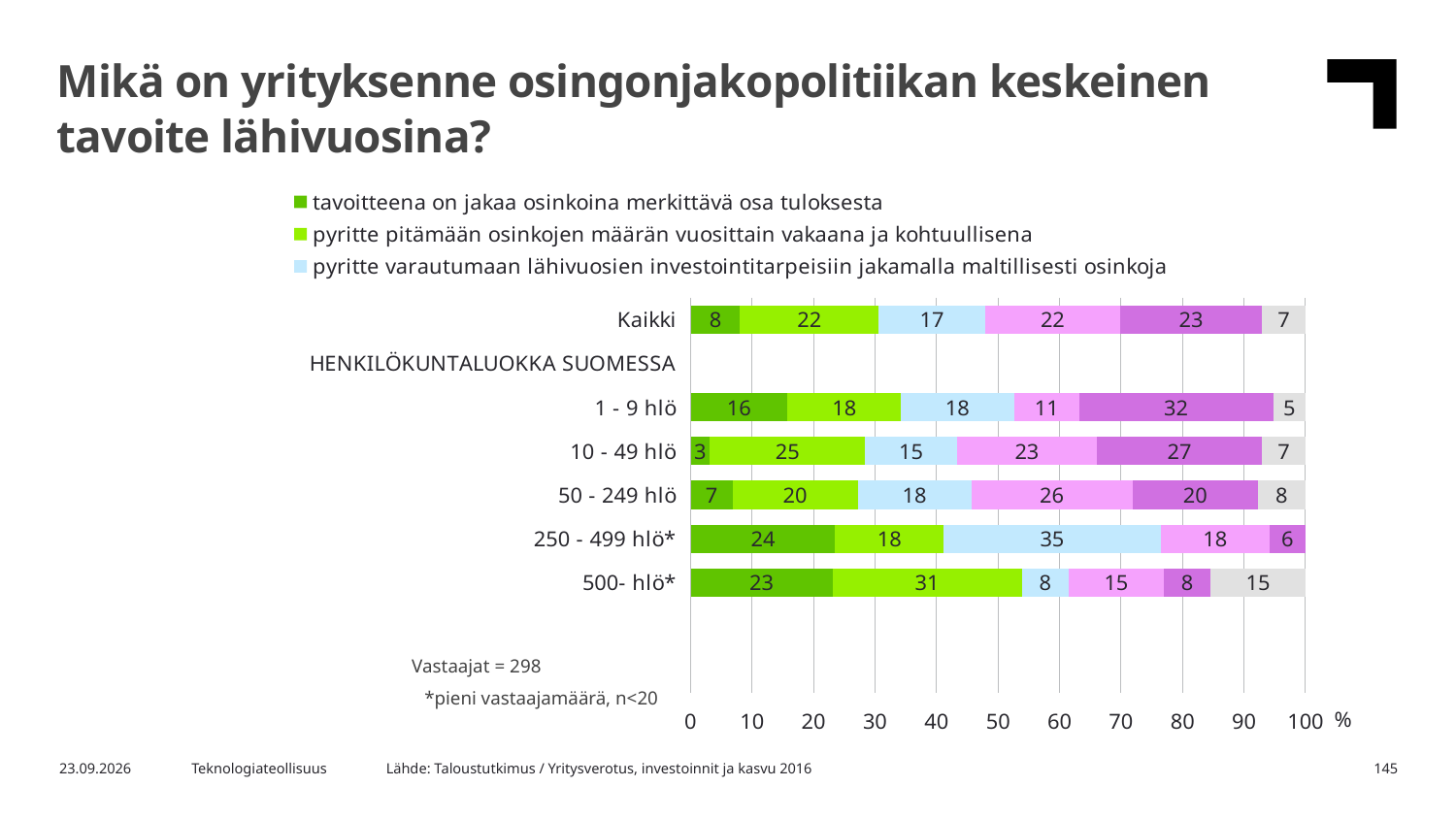
How many series does the legend list? 3 What is the value for 'pyritte pitämään osinkojen määrän vuosittain vakaana ja kohtuullisena' for 10 - 49 hlö? 25 What kind of chart is shown on the slide? bar chart Which category has the lowest value for 'pyritte varautumaan lähivuosien investointitarpeisiin jakamalla maltillisesti osinkoja'? 500- hlö* What is the title of the chart on the slide? Mikä on yrityksenne osingonjakopolitiikan keskeinen tavoite lähivuosina? How many categories have bars plotted in the chart? 6 Which category has the lowest value for 'tavoitteena on jakaa osinkoina merkittävä osa tuloksesta'? 10 - 49 hlö In the Kaikki bar, what is the difference between the value for 'pyritte pitämään osinkojen määrän vuosittain vakaana ja kohtuullisena' and the value for 'tavoitteena on jakaa osinkoina merkittävä osa tuloksesta'? 14 Which category has the highest value for 'pyritte pitämään osinkojen määrän vuosittain vakaana ja kohtuullisena'? 500- hlö* What is the value for 'tavoitteena on jakaa osinkoina merkittävä osa tuloksesta' in the Kaikki bar? 8 What is the value for 'pyritte varautumaan lähivuosien investointitarpeisiin jakamalla maltillisesti osinkoja' for 250 - 499 hlö*? 35 Which has the larger value for 'tavoitteena on jakaa osinkoina merkittävä osa tuloksesta': 1 - 9 hlö or 10 - 49 hlö? 1 - 9 hlö